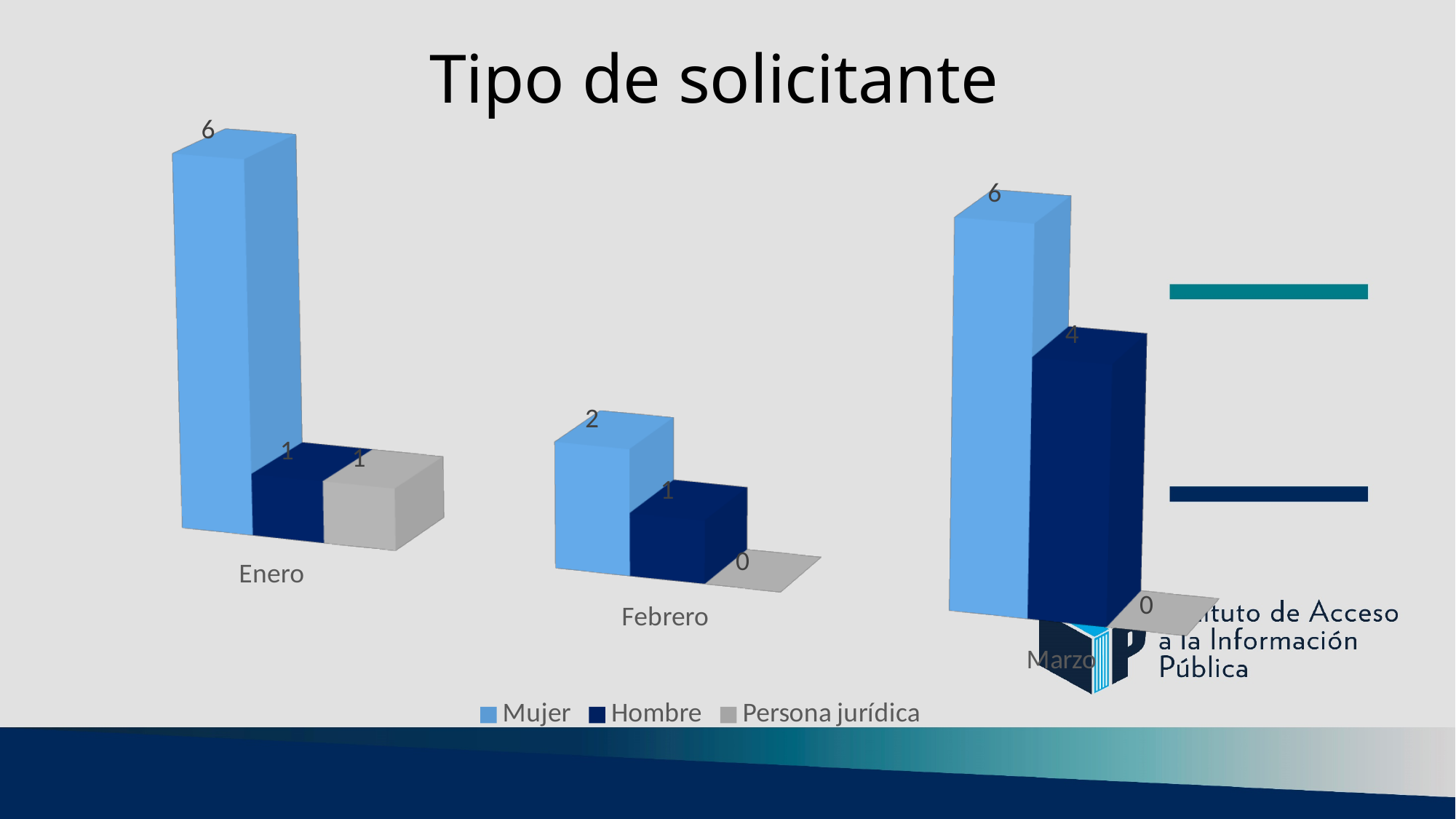
What is the value for Mujer in Febrero? 2 What is the value for Hombre in Marzo? 4 Which is larger in Enero: the Mujer value or the Hombre value? Mujer What kind of chart is shown on the slide? Bar chart In which month is the Mujer value lowest? Febrero What is the difference between the Mujer and Hombre values in Marzo? 2 What is the value for Persona jurídica in Febrero? 0 What is the title of the chart? Tipo de solicitante How many months are shown on the x axis? 3 In which month is the Hombre value highest? Marzo How many series does the legend list? 3 What is the value for Mujer in Enero? 6